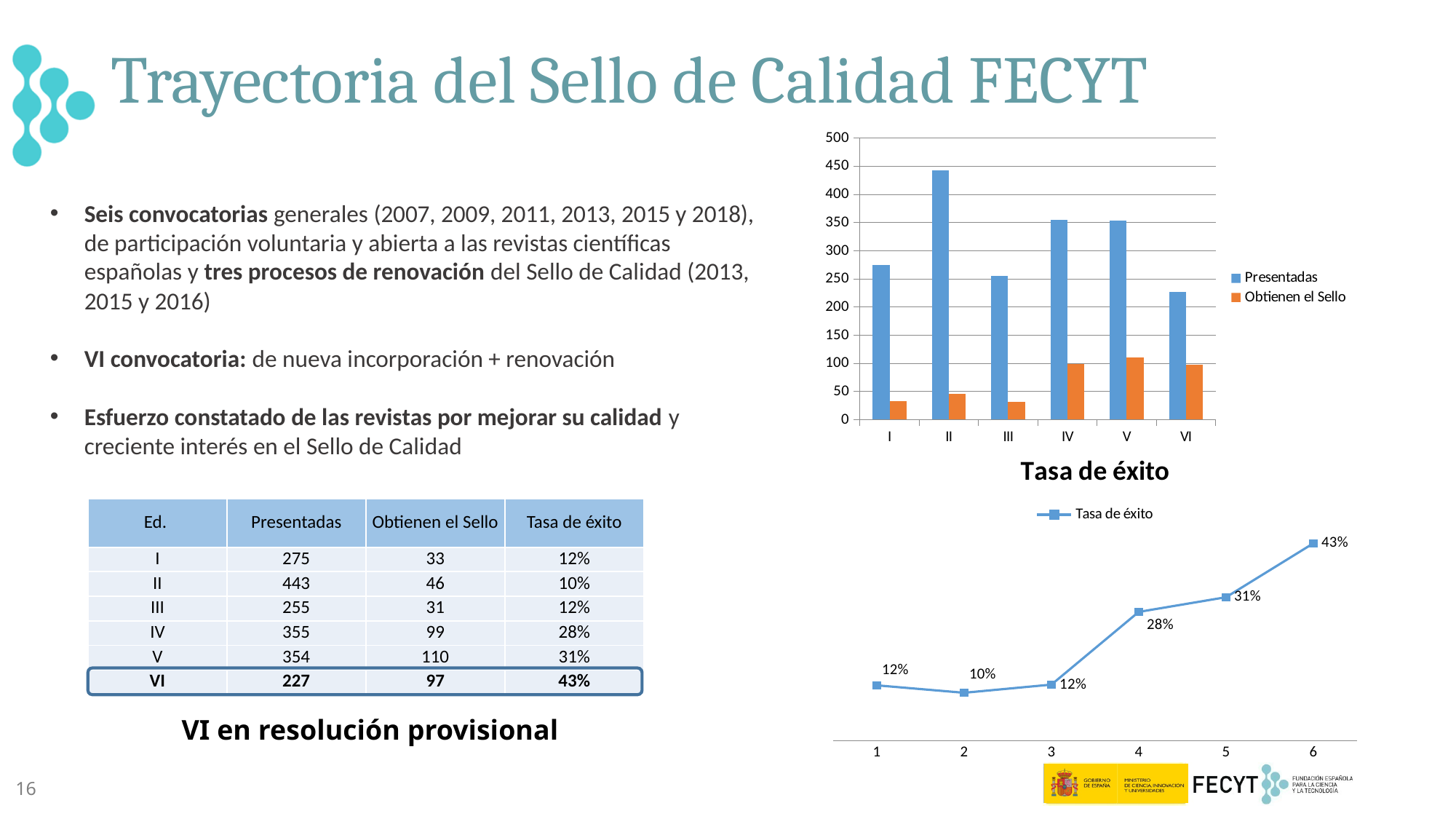
In the 'Tasa de éxito' line chart, do the values generally rise or fall from point 3 to point 6? rise In the top-right bar chart, is the Obtienen el Sello value for I greater or less than 50? less In the 'Tasa de éxito' line chart, what is the value at point 6? 43% In the top-right bar chart, which is larger: the Obtienen el Sello value for IV or for I? IV In the top-right bar chart, which category has the highest Presentadas value? II What kind of chart is the top-right chart with the Presentadas and Obtienen el Sello series? bar chart In the 'Tasa de éxito' line chart, what is the difference between the value at point 6 and the value at point 3? 31 percentage points In the top-right bar chart, is the Presentadas value for VI greater or less than 250? less In the top-right bar chart, is the Presentadas value for II greater or less than 400? greater How many categories are shown on the x axis of the top-right bar chart? 6 How many series does the legend of the top-right bar chart list? 2 In the 'Tasa de éxito' line chart, which point has the lowest value? 2